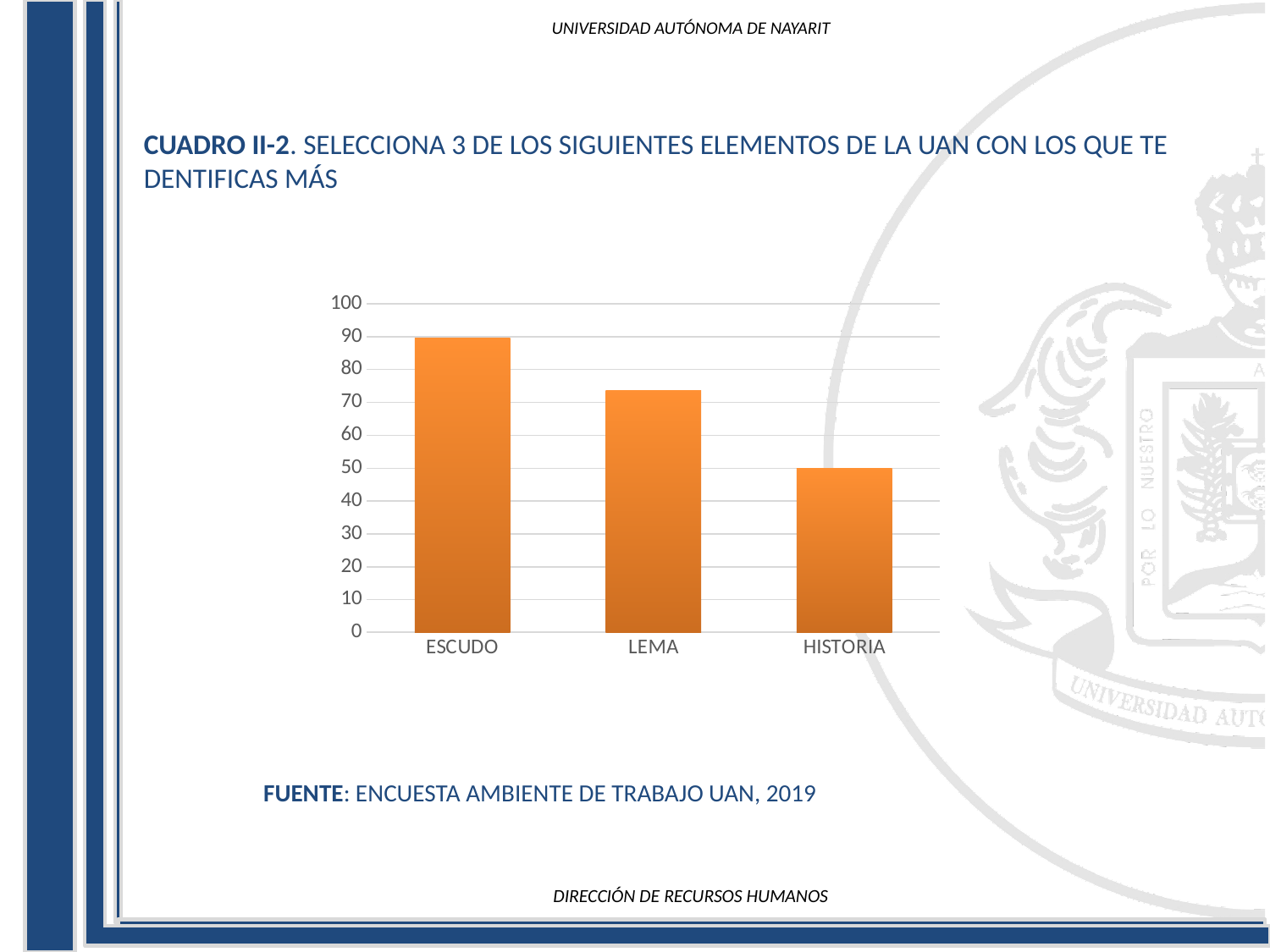
How many categories are shown on the x axis of the chart? 3 Is the value for LEMA greater or less than 80? less Which category has the lowest bar in the chart? HISTORIA Is the value for LEMA greater or less than 70? greater Which is larger, the value for LEMA or the value for HISTORIA? LEMA Is the value for ESCUDO greater or less than 80? greater Do the bar values rise or fall from left to right along the x axis? fall Which category has the highest bar in the chart? ESCUDO What is the source cited below the chart? ENCUESTA AMBIENTE DE TRABAJO UAN, 2019 What kind of chart is shown on the slide? bar chart Which is larger, the value for ESCUDO or the value for LEMA? ESCUDO